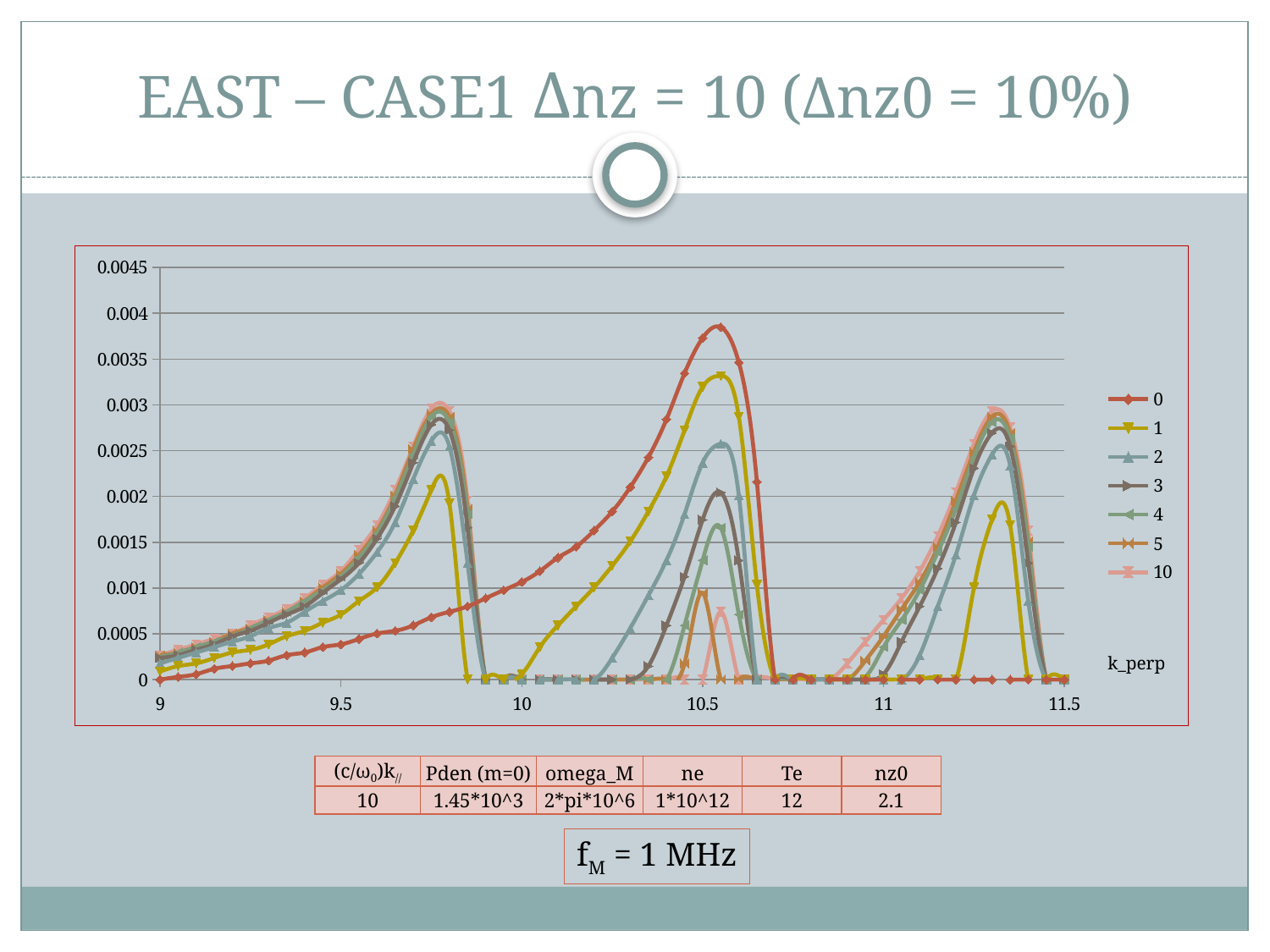
Is the peak value of series 10 near k_perp 10.5 greater or less than 0.001? less Is the peak value of series 5 near k_perp 10.5 greater or less than 0.0015? less How many tick labels are shown on the x axis? 6 Does series 0 rise or fall as k_perp increases from 9 to 10.5? rises What are the entries in the chart legend? 0, 1, 2, 3, 4, 5, 10 What kind of chart is shown on the slide? line chart What label is shown for the x axis of the chart? k_perp Is the peak value of series 1 near k_perp 9.75 greater or less than 0.0025? less Which series reaches the highest peak value on the chart? 0 How many series does the legend list? 7